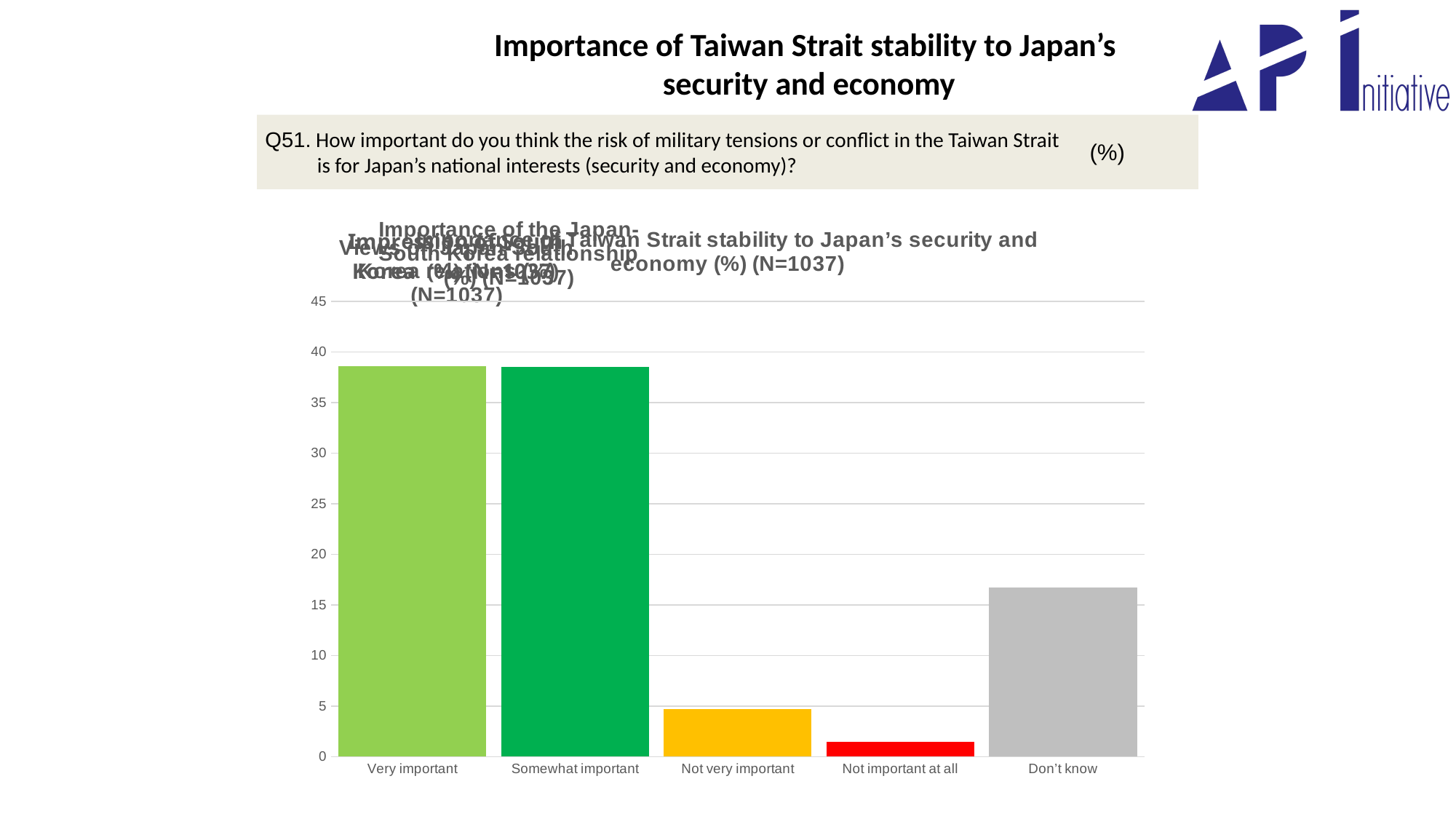
What kind of chart is shown on the slide? bar chart How many categories are shown on the x axis of the chart? 5 Which is larger, the value for Very important or the value for Don't know? Very important What colour is the bar for Not important at all? red Is the value for Very important greater or less than 35? greater Is the value for Somewhat important greater or less than 40? less Is the value for Don't know greater or less than 15? greater What colour is the bar for Don't know? grey Which category has the lowest value in the chart? Not important at all Which is larger, the value for Don't know or the value for Not very important? Don't know